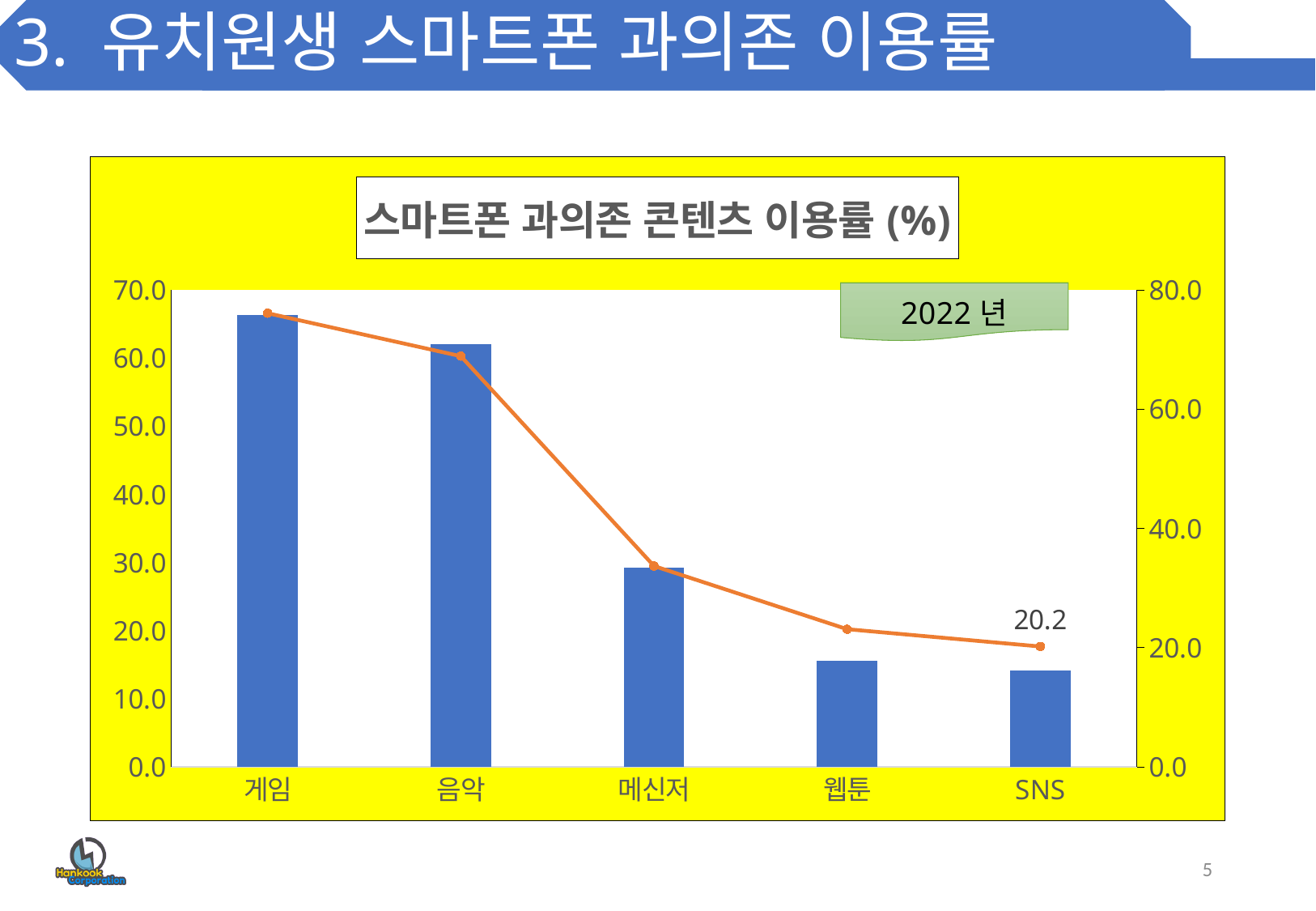
Which bar is taller, 메신저 or 웹툰? 메신저 On the left axis, is the bar value for 게임 greater or less than 60.0? greater Which bar is taller, 게임 or 음악? 게임 What is the data label shown on the line for SNS? 20.2 Which category has the lowest bar? SNS What is the title of the chart? 스마트폰 과의존 콘텐츠 이용률 (%) On the left axis, is the bar value for 웹툰 greater or less than 20.0? less Do the bar values rise or fall from 게임 to SNS along the x axis? Fall On the left axis, is the bar value for 음악 greater or less than 50.0? greater What kind of chart is shown on the slide? Bar chart with a line How many categories are shown on the x axis? 5 Which category has the highest bar? 게임